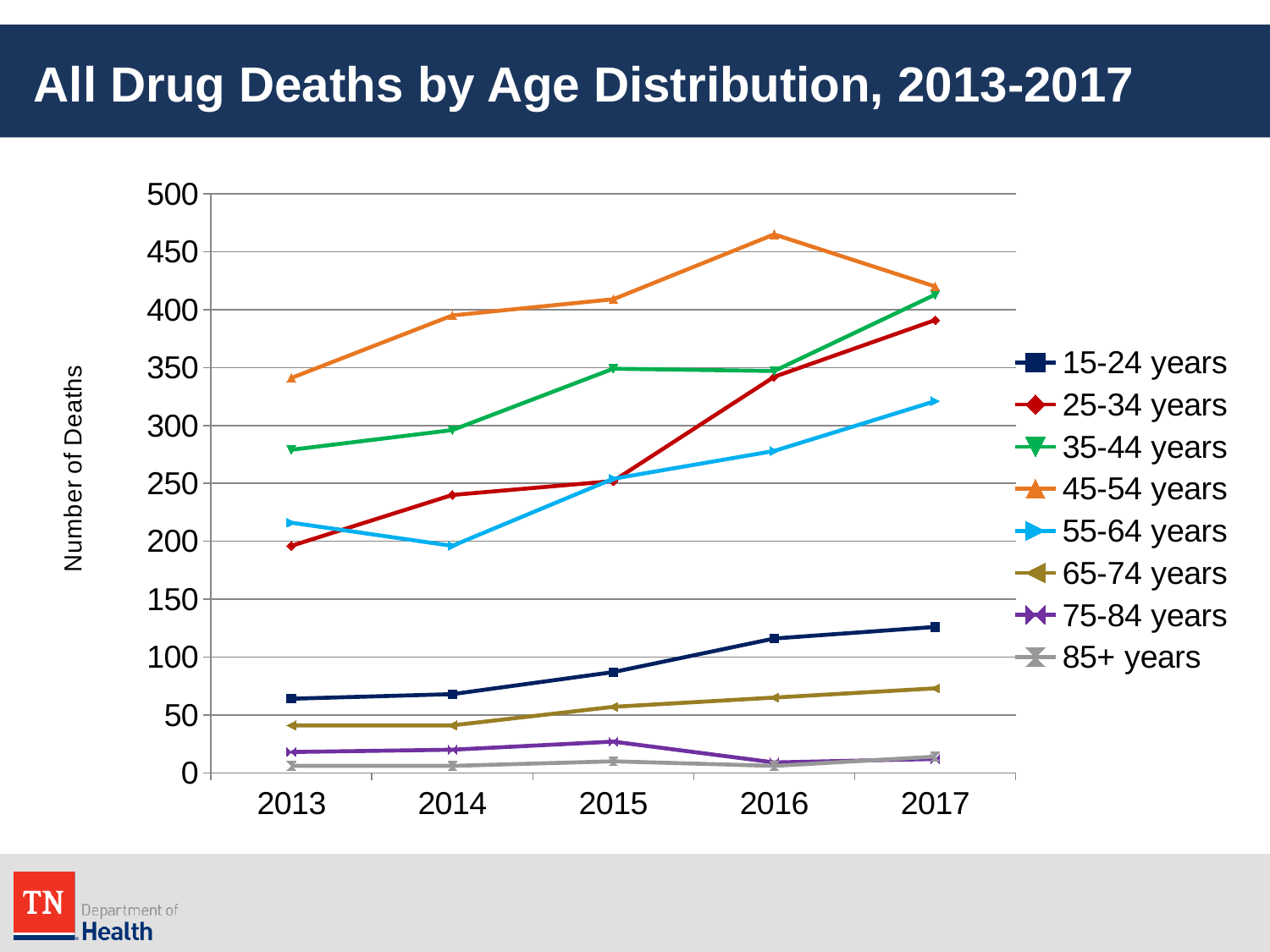
Is the value for 15-24 years in 2017 greater or less than 100? greater How many years are plotted along the x axis? 5 Is the value for 45-54 years in 2016 greater or less than 450? greater What is the label on the y axis of the chart? Number of Deaths Do drug deaths for the 15-24 years group rise or fall from 2013 to 2017? rise What kind of chart is shown on the slide? line chart In 2017, which had more drug deaths: 35-44 years or 25-34 years? 35-44 years Which age group had the highest number of drug deaths in 2016? 45-54 years In which year does the 45-54 years line reach its peak? 2016 Is the value for 55-64 years in 2017 greater or less than 300? greater How many age groups does the legend list? 8 Which age group had the lowest number of drug deaths in 2013? 85+ years